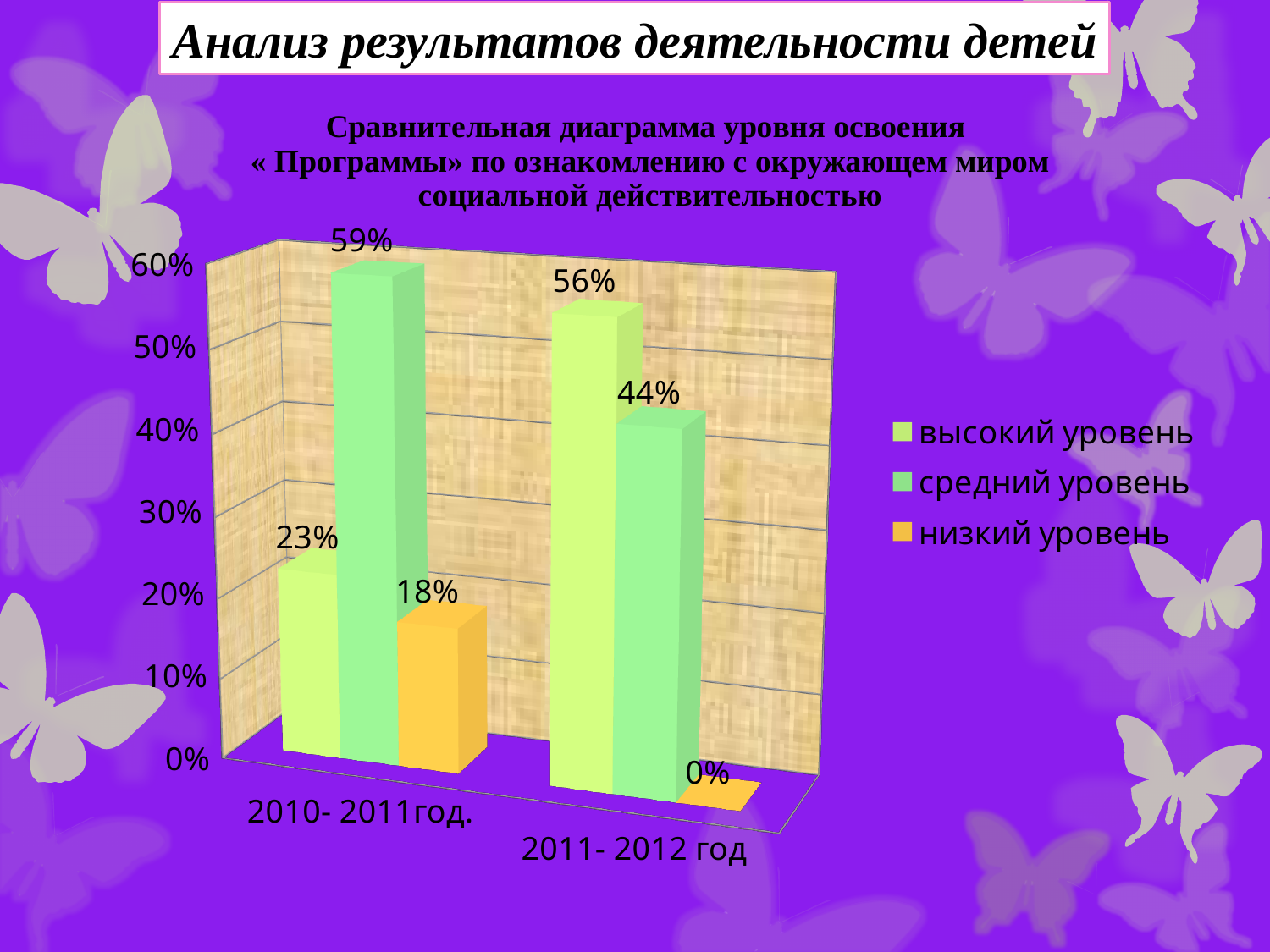
What is the value for высокий уровень in 2010-2011год.? 23% Which level has the lowest value in 2011-2012 год? низкий уровень What is the difference between высокий уровень in 2011-2012 год and in 2010-2011год.? 33% What kind of chart is shown on the slide? bar chart What is the value for средний уровень in 2011-2012 год? 44% What is the value for низкий уровень in 2010-2011год.? 18% What is the value for низкий уровень in 2011-2012 год? 0% Which is larger: средний уровень in 2010-2011год. or средний уровень in 2011-2012 год? средний уровень in 2010-2011год. Does the value for высокий уровень rise or fall from 2010-2011год. to 2011-2012 год? rise Which level has the highest value in 2010-2011год.? средний уровень How many categories are shown on the x axis? 2 How many series does the legend list? 3